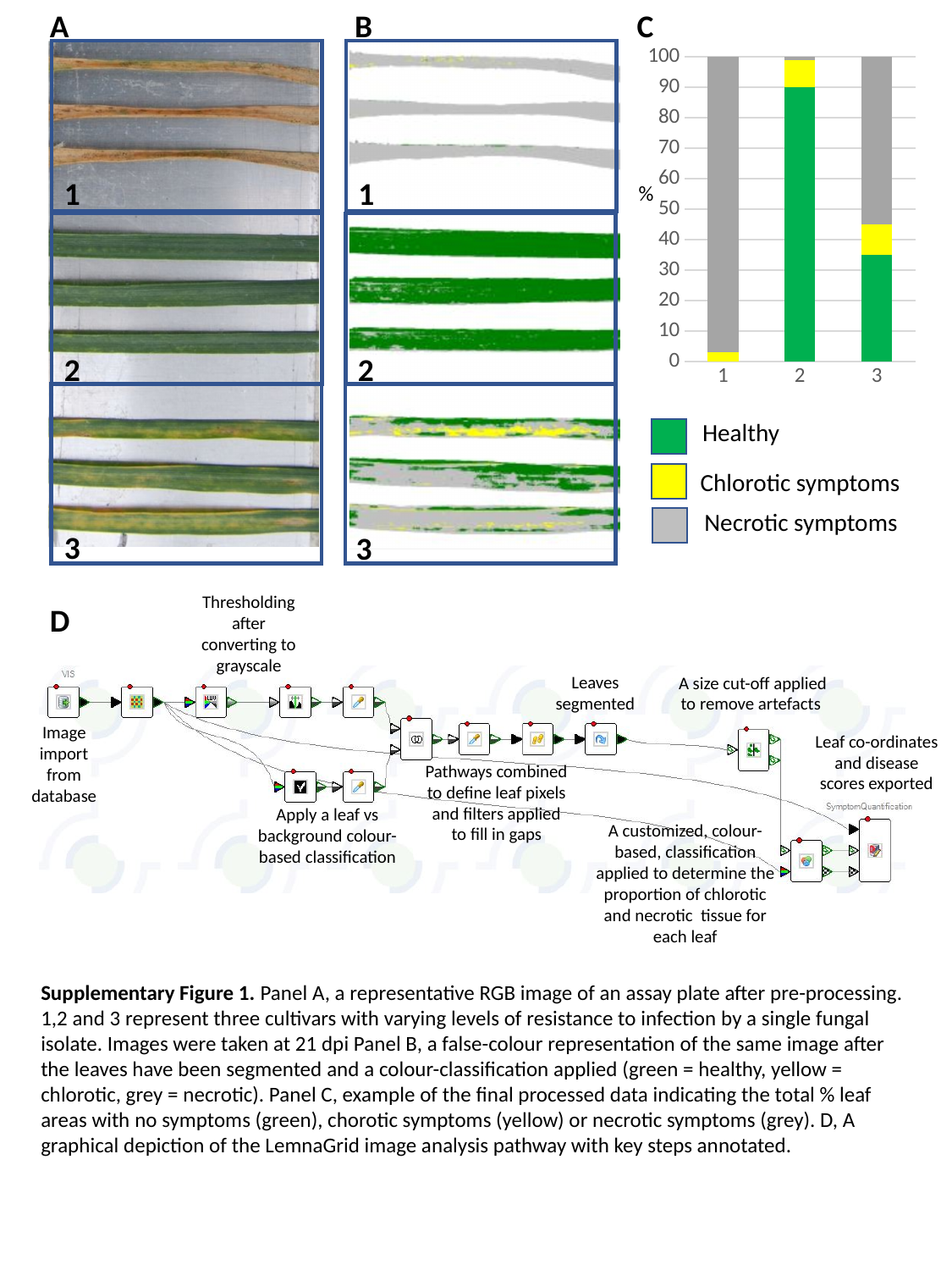
In Panel C, is the Healthy value for cultivar 3 greater or less than 50? less In Panel C, which cultivar has a larger Healthy share, 2 or 3? 2 In Panel C, is the Necrotic symptoms value for cultivar 1 greater or less than 90? greater In Panel C, what is the total height of the stacked bar for cultivar 1? 100 In Panel C, which cultivar has the smallest Healthy (green) share? 1 In Panel C, how many cultivars (categories) are plotted on the x axis? 3 In Panel C, what colour represents Chlorotic symptoms in the legend? Yellow In Panel C, how many series does the legend list? 3 In Panel C, is the Healthy value for cultivar 2 greater or less than 80? greater In Panel C, which cultivar has the largest Healthy (green) share? 2 In Panel C, which cultivar has the largest Necrotic symptoms (grey) share? 1 In Panel C, what kind of chart is shown? Stacked bar chart